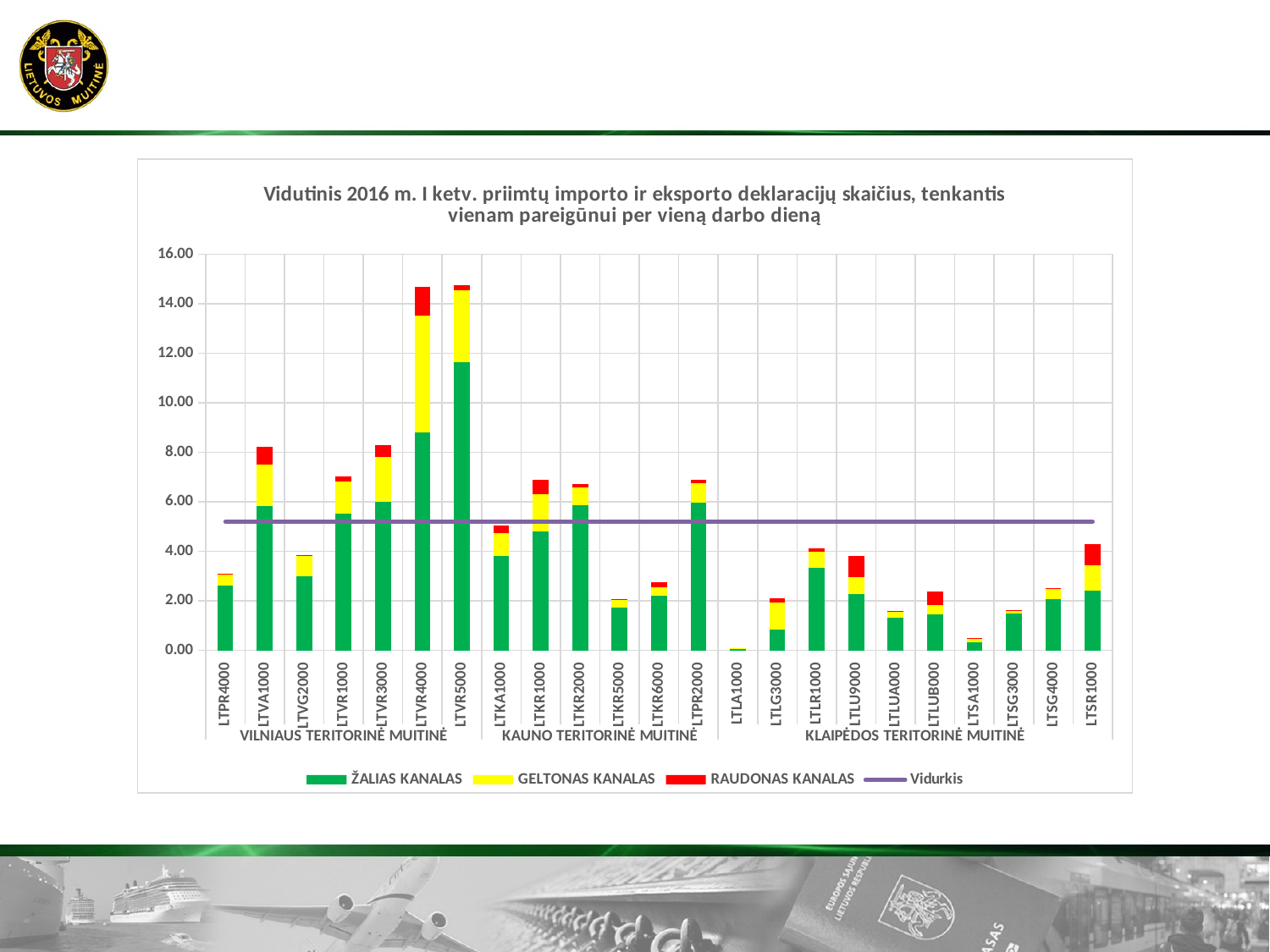
Which customs post has the lowest total bar? LTLA1000 What kind of chart is shown on the slide? Stacked bar chart (with an average line) Which has the larger total bar, LTVR4000 or LTPR4000? LTVR4000 Which has the larger total bar, LTKR1000 or LTKR5000? LTKR1000 How many customs posts (bars) are shown along the x axis? 23 How many entries does the legend list? 4 Which series is shown in red in the legend? RAUDONAS KANALAS Is the total value for LTKR5000 greater or less than 4.00? less Is the total value for LTLA1000 greater or less than 2.00? less Is the total value for LTVR4000 greater or less than 14.00? greater Into how many territorial customs groups are the bars divided on the x axis? 3